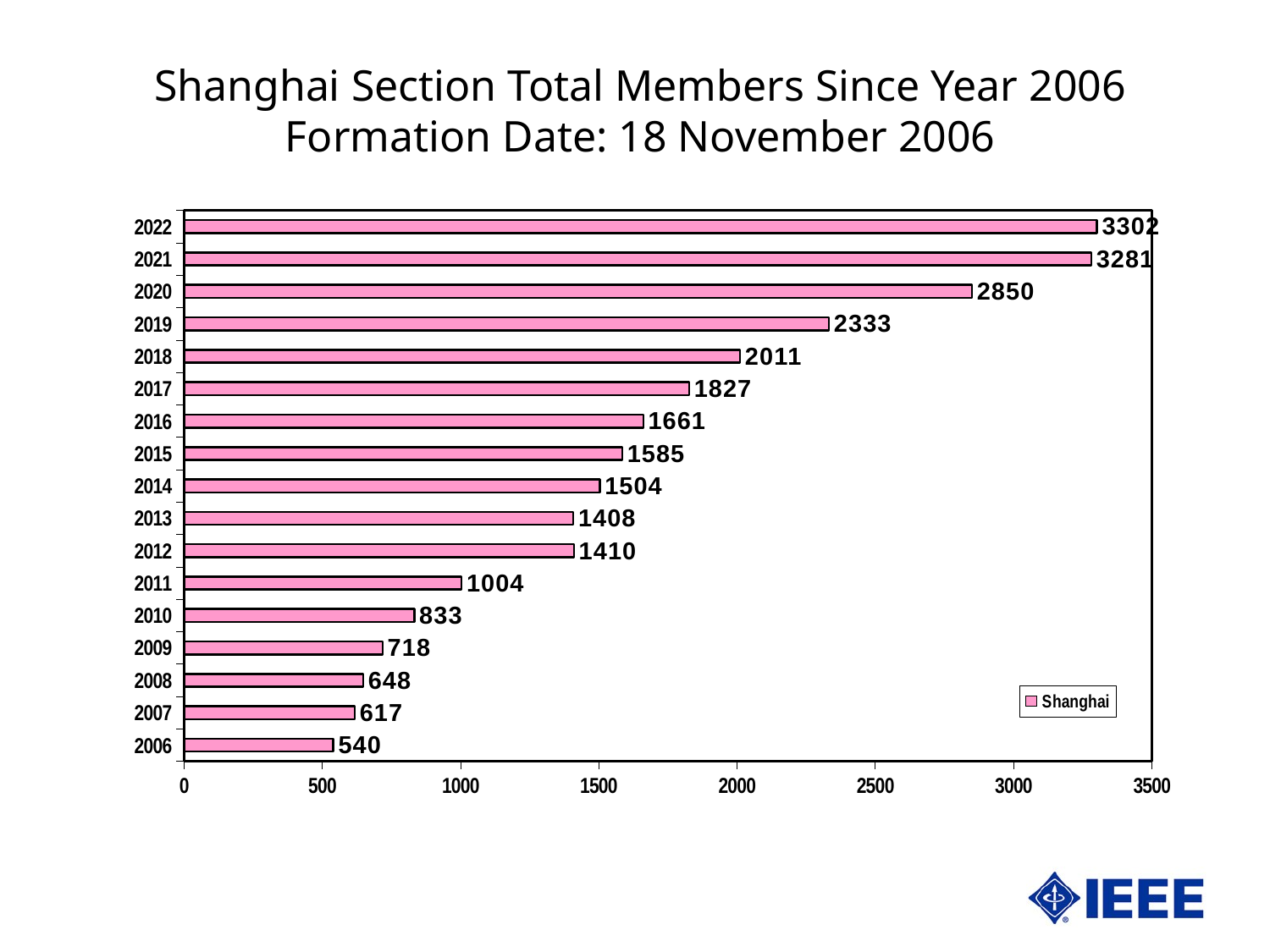
What is the difference between the values for 2020 and 2019? 517 Which year has the highest value? 2022 Which year has the lowest value? 2006 What is the value for 2015? 1585 What is the difference between the values for 2022 and 2021? 21 Which is larger, the value for 2012 or the value for 2013? 2012 What series name does the legend show? Shanghai How many years are shown in the chart? 17 Is the value for 2018 greater or less than 2000? greater What kind of chart is this? bar chart What is the value for 2022? 3302 What is the value for 2006? 540